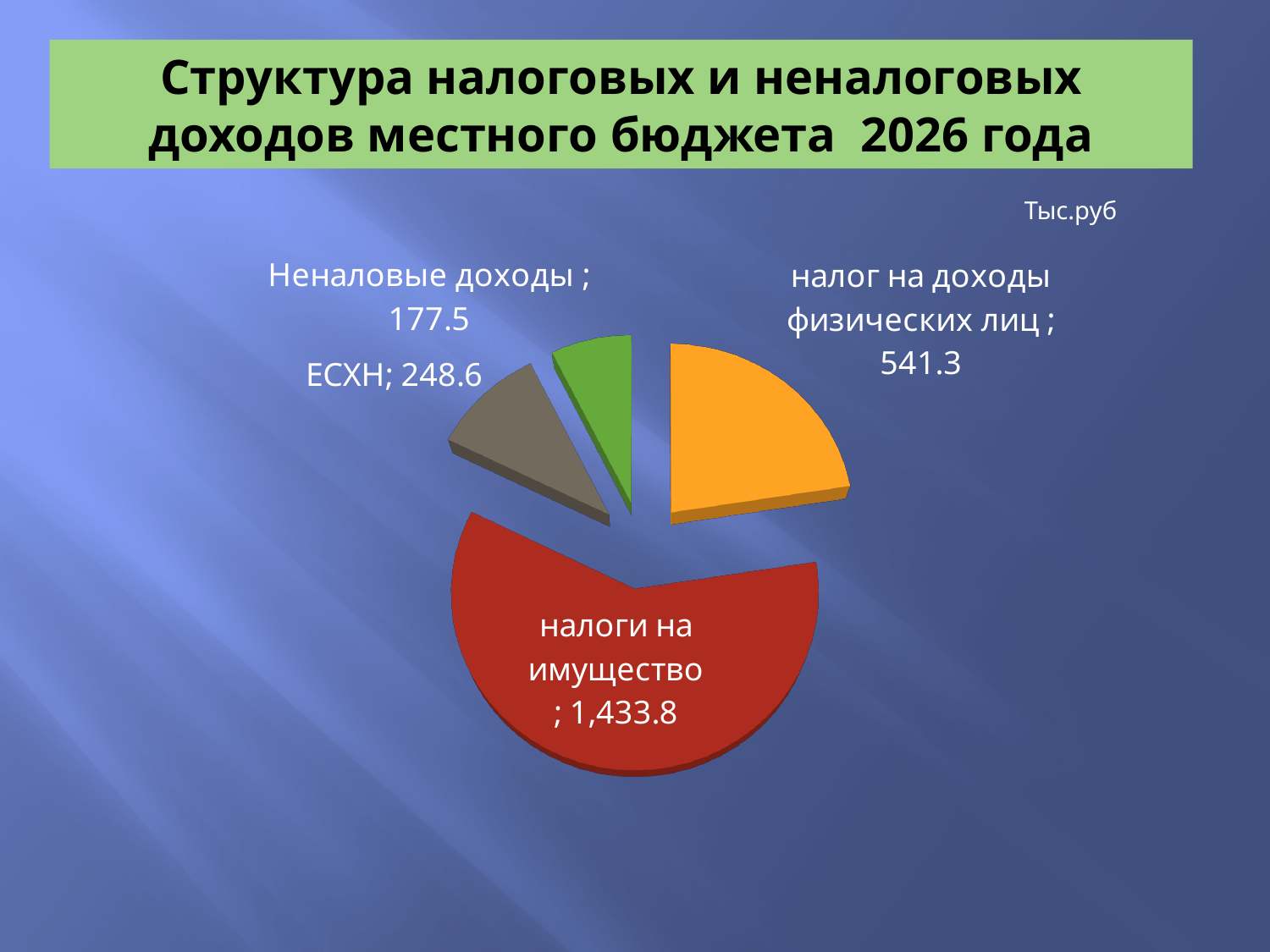
Which is larger, ЕСХН or Неналовые доходы? ЕСХН Which category has the largest slice of the pie? налоги на имущество What is the value for ЕСХН? 248.6 What is the value for Неналовые доходы? 177.5 In what units are the values on the chart given? Тыс.руб What is the difference between ЕСХН and Неналовые доходы? 71.1 What type of chart is shown on the slide? Pie chart Which category has the smallest slice of the pie? Неналовые доходы How many slices does the pie chart have? 4 What is the difference between налоги на имущество and налог на доходы физических лиц? 892.5 What is the value for налог на доходы физических лиц? 541.3 What is the value for налоги на имущество? 1,433.8